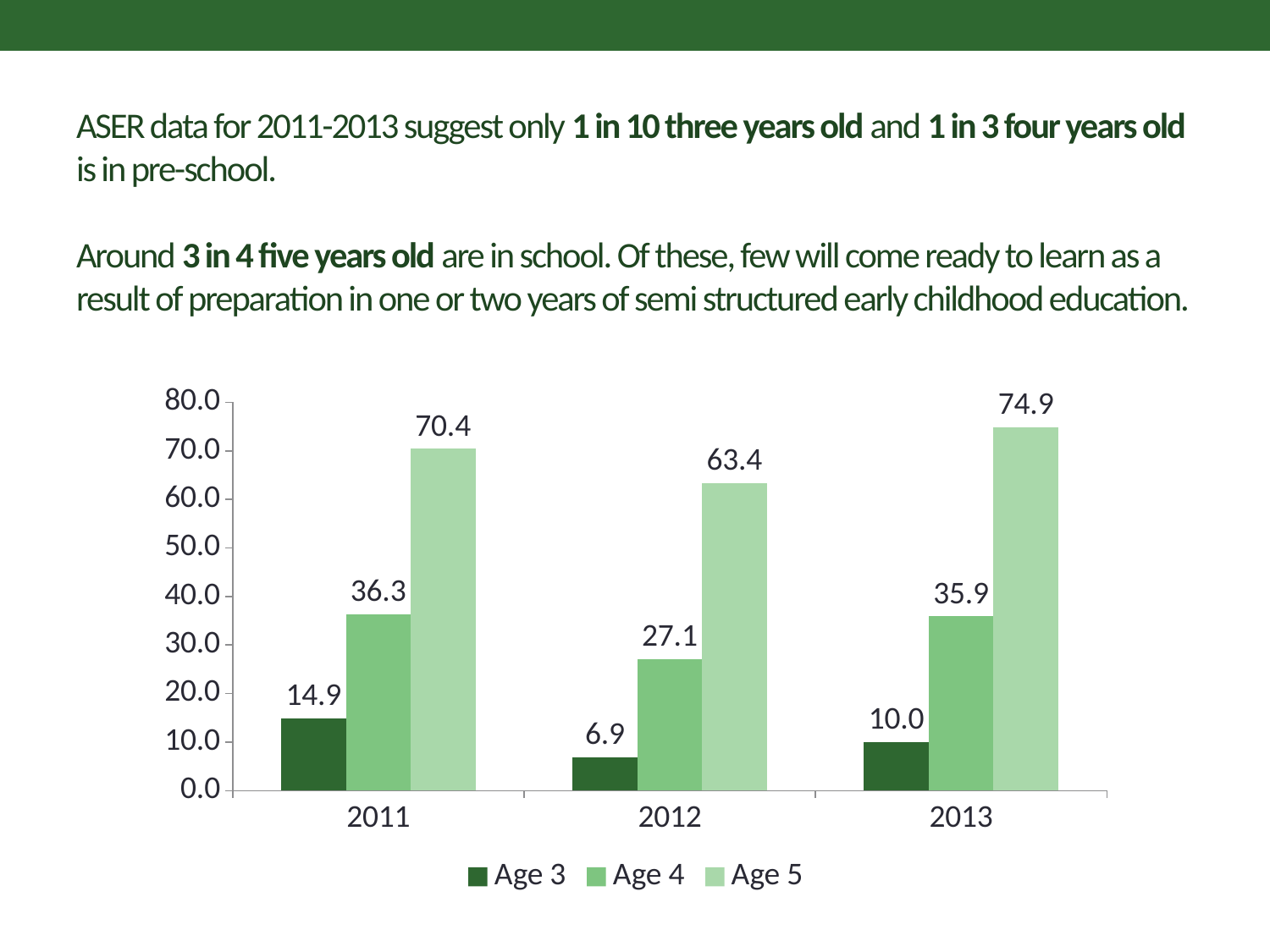
How many series does the legend list? 3 What kind of chart is shown on the slide? bar chart What is the value for Age 5 in 2013? 74.9 Which is larger, the Age 4 value in 2011 or the Age 4 value in 2013? 2011 Which year has the lowest value for Age 3? 2012 Which series is shown in the darkest green? Age 3 How many years are shown on the x axis? 3 What is the difference between the Age 5 value in 2013 and the Age 5 value in 2012? 11.5 What is the value for Age 4 in 2012? 27.1 Is the value for Age 5 in 2012 greater or less than 60.0? greater What is the value for Age 3 in 2011? 14.9 Which year has the highest value for Age 5? 2013